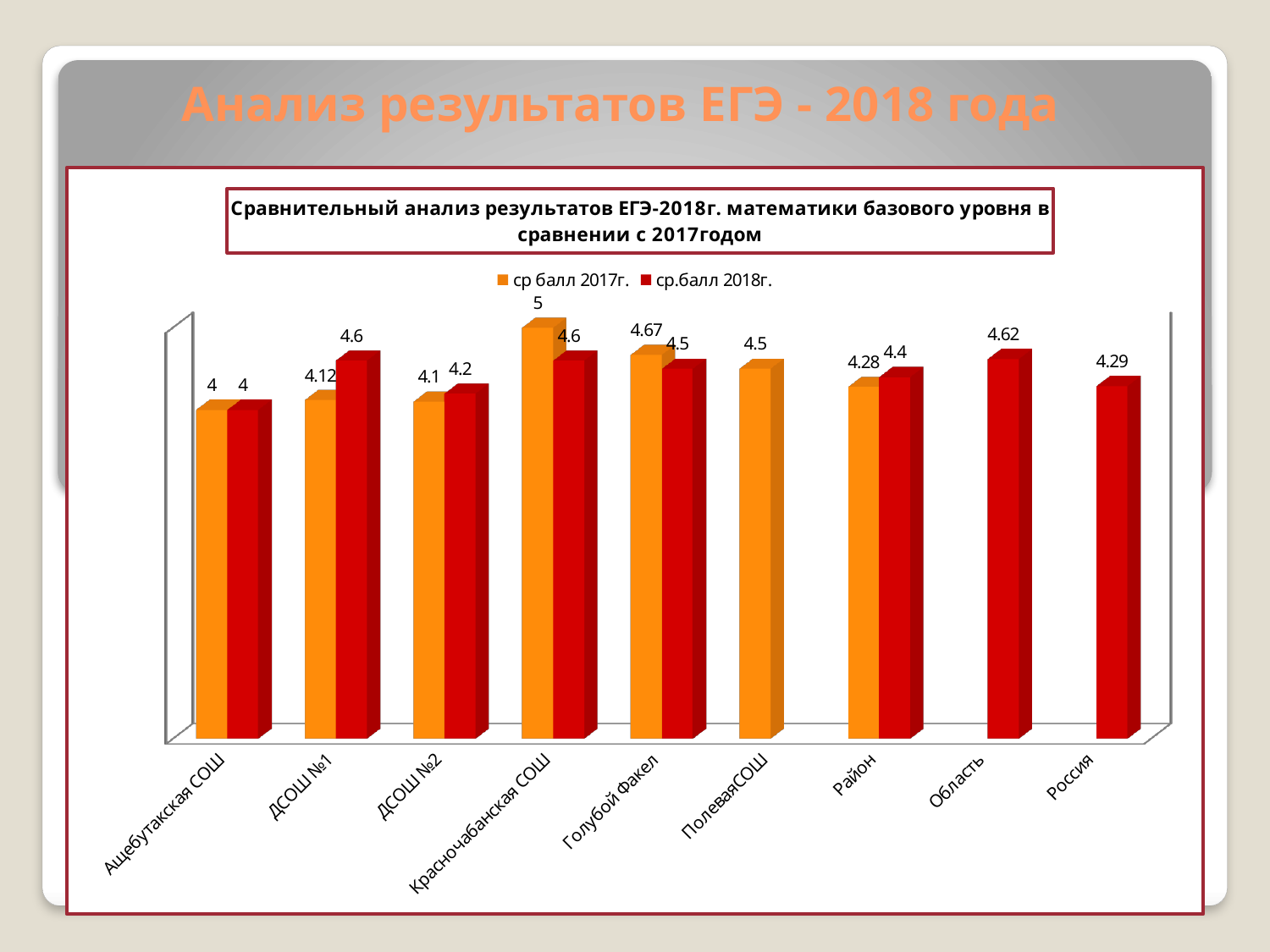
For Красночабанская СОШ, which is larger: ср балл 2017г. or ср.балл 2018г.? ср балл 2017г. Which category has the lowest value for ср.балл 2018г.? Ащебутакская СОШ What is the value of ср балл 2017г. for Голубой Факел? 4.67 Which category has the highest value for ср.балл 2018г.? Область How many series does the legend list? 2 What is the value of ср.балл 2018г. for Область? 4.62 Which category has the highest value for ср балл 2017г.? Красночабанская СОШ What kind of chart is shown on the slide? bar chart What is the value of ср балл 2017г. for Район? 4.28 What is the difference between ср.балл 2018г. and ср балл 2017г. for ДСОШ №1? 0.48 How many categories are shown along the x axis? 9 What is the value of ср.балл 2018г. for ДСОШ №1? 4.6